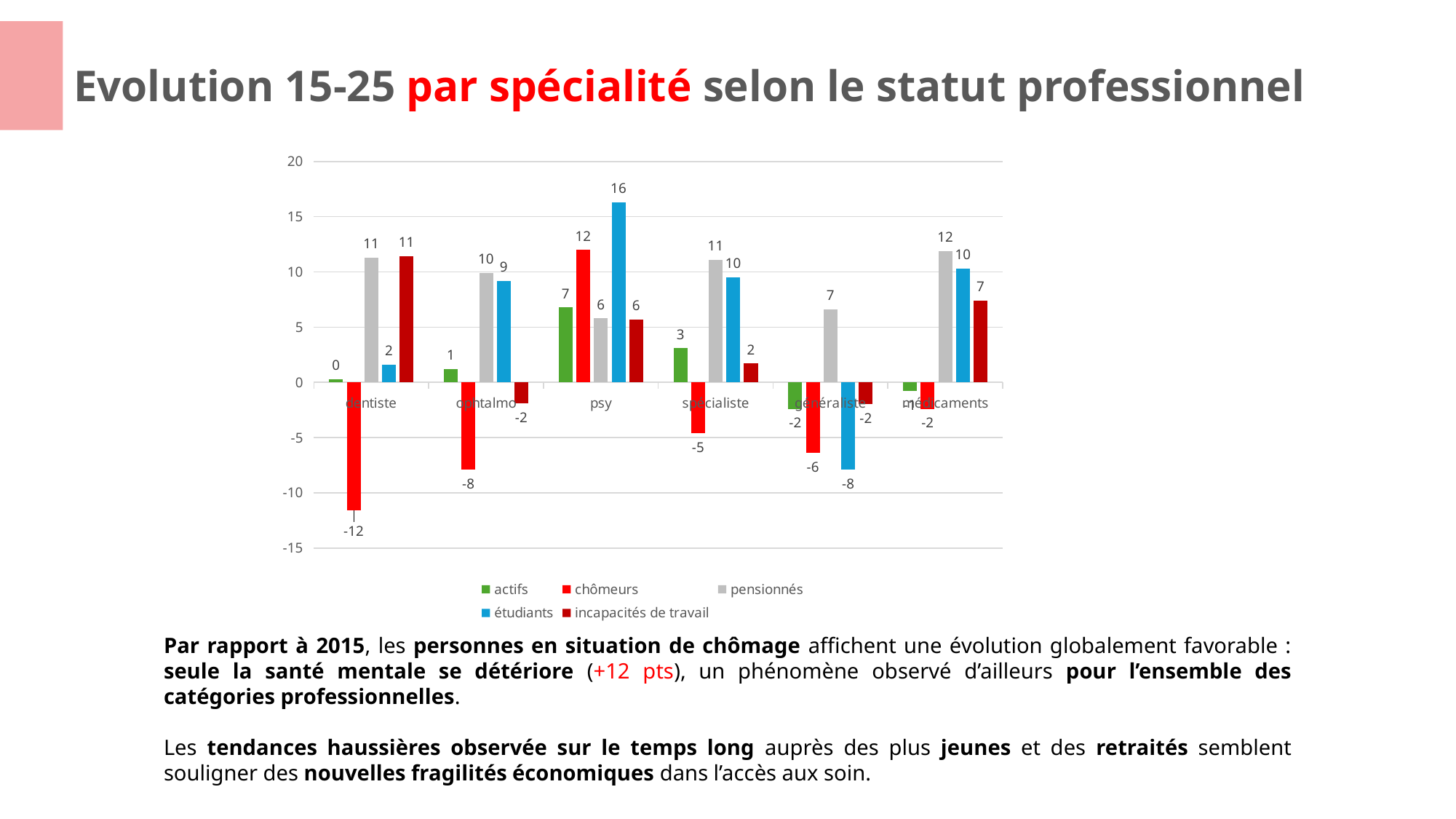
How many series does the legend list? 5 What is the value for étudiants in the psy category? 16 Which is larger: the pensionnés value for dentiste or the pensionnés value for généraliste? dentiste In which category is the étudiants value highest? psy What is the value for étudiants in the généraliste category? -8 How many categories are shown on the x axis? 6 What is the value for chômeurs in the dentiste category? -12 What kind of chart is shown on the slide? bar chart What is the value for chômeurs in the psy category? 12 What is the difference between the pensionnés and étudiants values in the ophtalmo category? 1 In which category is the chômeurs value lowest? dentiste What colour represents the chômeurs series in the legend? red